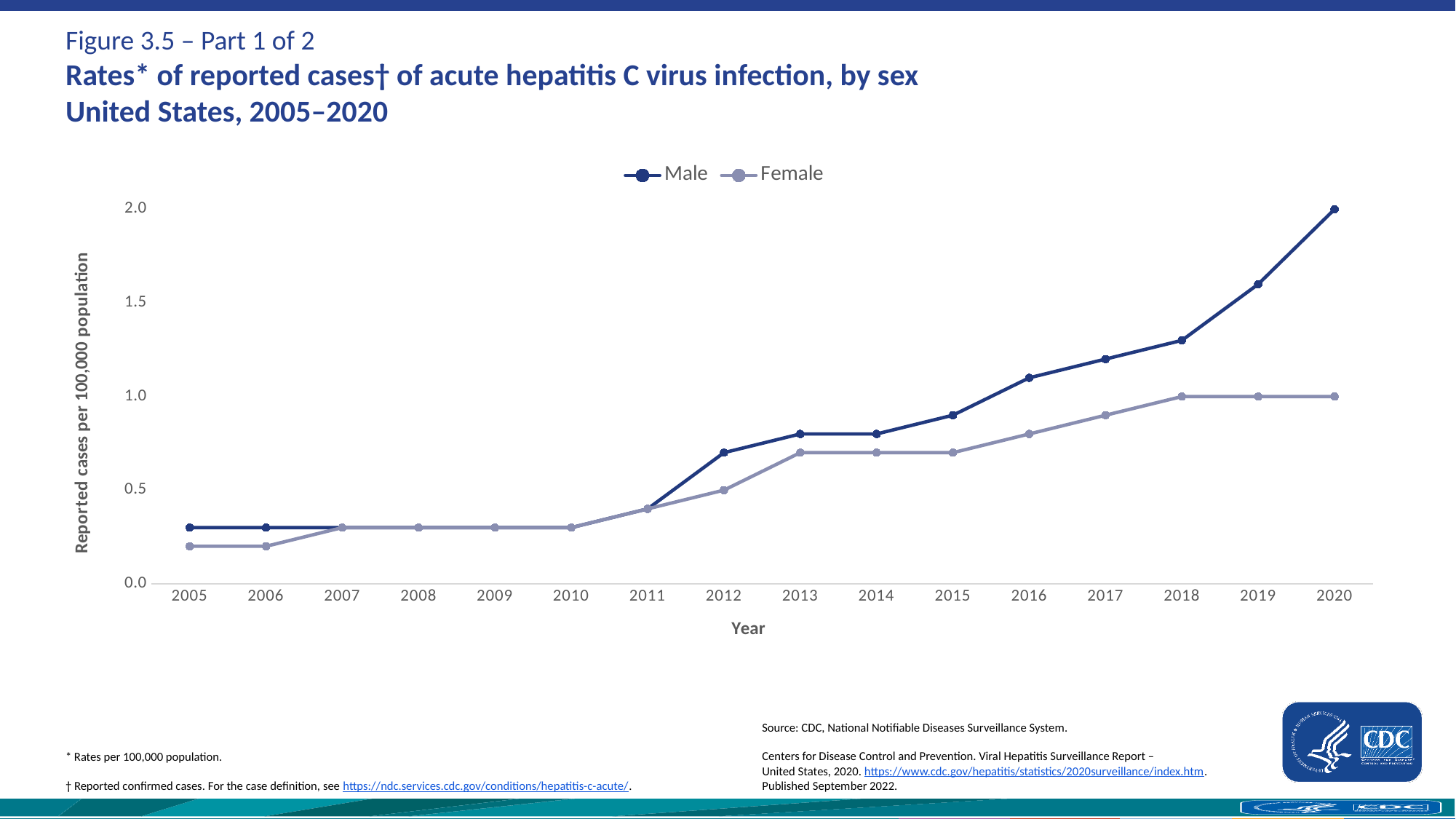
Is the Male rate in 2019 greater or less than 1.5? greater How many series does the legend list? 2 What is the label of the y axis? Reported cases per 100,000 population Is the Male rate in 2005 greater or less than 0.5? less Is the Female rate in 2017 greater or less than 1.0? less Which year has the highest Male rate? 2020 Does the Male rate generally rise or fall from 2005 to 2020? rise What kind of chart is shown on the slide? line chart In 2020, which series has the higher rate, Male or Female? Male How many years are plotted along the x axis? 16